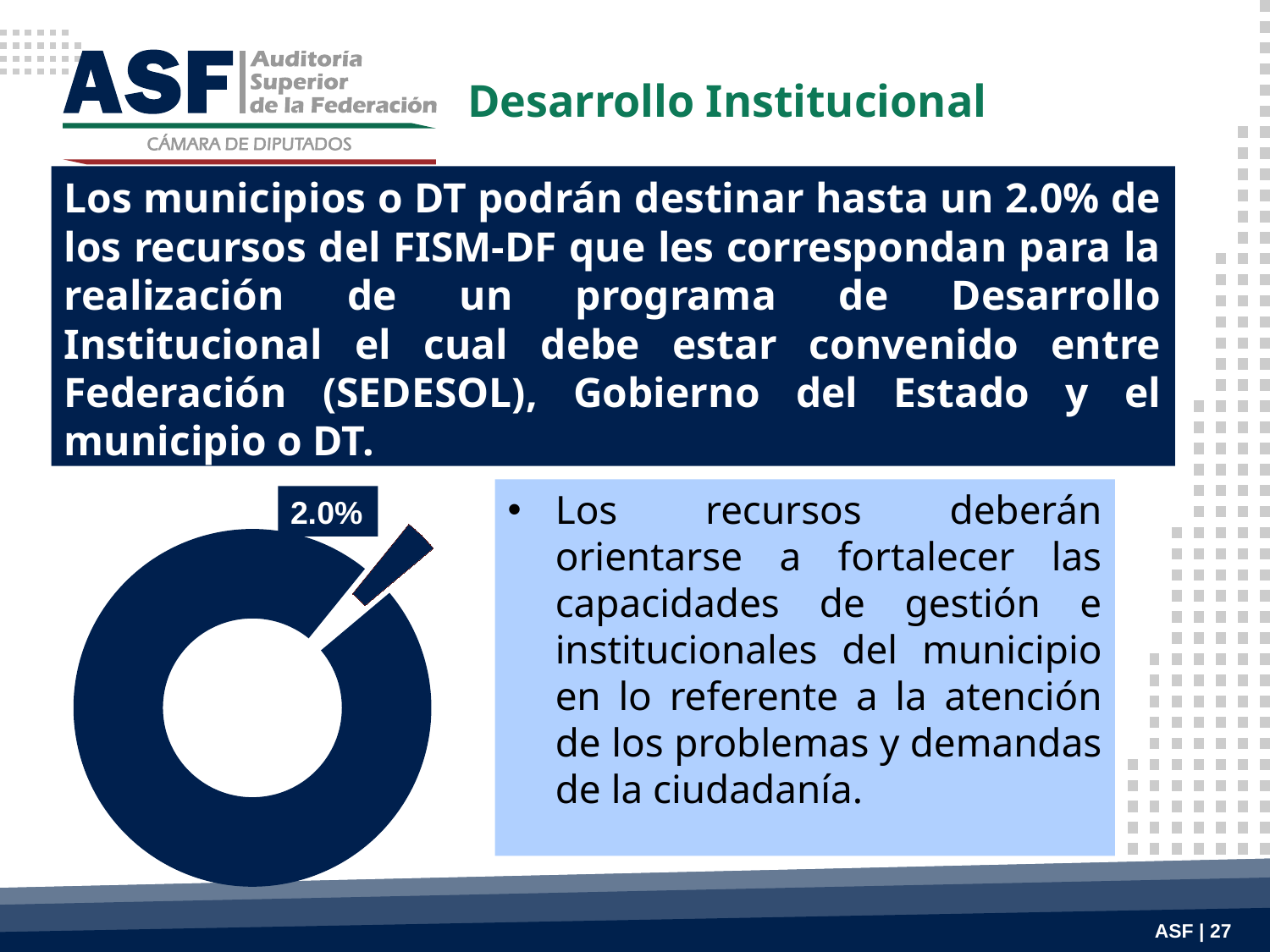
Which slice of the doughnut chart is larger, the small exploded slice or the remaining slice? The remaining slice What value is printed as the data label on the small exploded slice of the doughnut chart? 2.0% How many slices does the doughnut chart have? 2 Which slice of the doughnut chart is the smallest? The exploded slice labelled 2.0% What share of the doughnut does the small exploded slice represent? 2.0% What colour are the slices of the doughnut chart? Dark navy blue Does the doughnut chart show a legend? No What kind of chart is shown on the slide? Doughnut chart